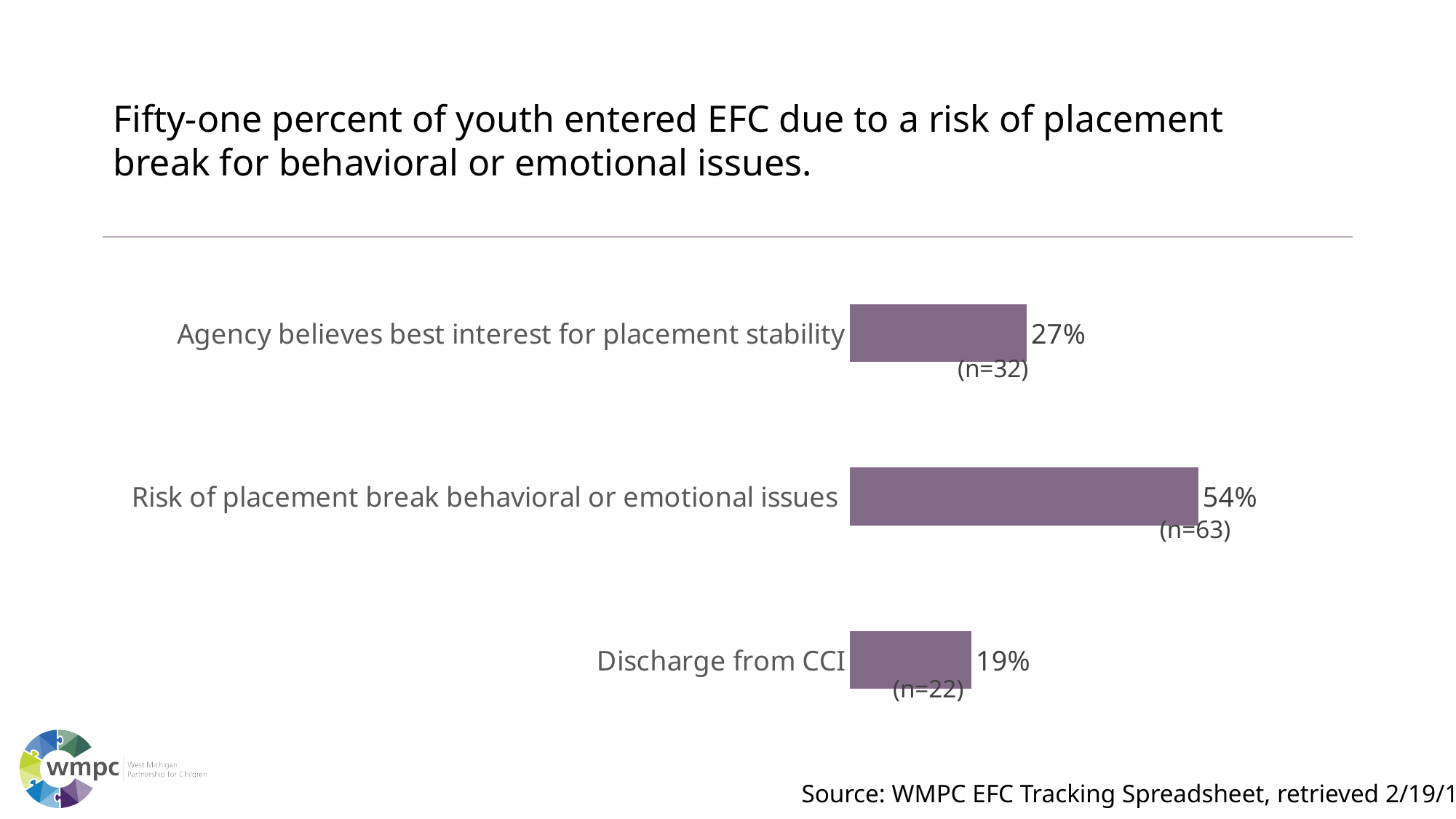
What is the difference in percentage points between "Risk of placement break behavioral or emotional issues" and "Agency believes best interest for placement stability"? 27 percentage points What is the n value shown for "Discharge from CCI"? n=22 What is the n value shown for "Risk of placement break behavioral or emotional issues"? n=63 What is the source cited at the bottom of the slide? WMPC EFC Tracking Spreadsheet Which category has the highest percentage? Risk of placement break behavioral or emotional issues What percentage is shown for "Risk of placement break behavioral or emotional issues"? 54% Which category has the lowest percentage? Discharge from CCI Which is larger: the percentage for "Agency believes best interest for placement stability" or for "Discharge from CCI"? Agency believes best interest for placement stability What percentage is shown for "Agency believes best interest for placement stability"? 27% How many categories are shown in the chart? 3 What kind of chart is shown on the slide? Bar chart What percentage is shown for "Discharge from CCI"? 19%